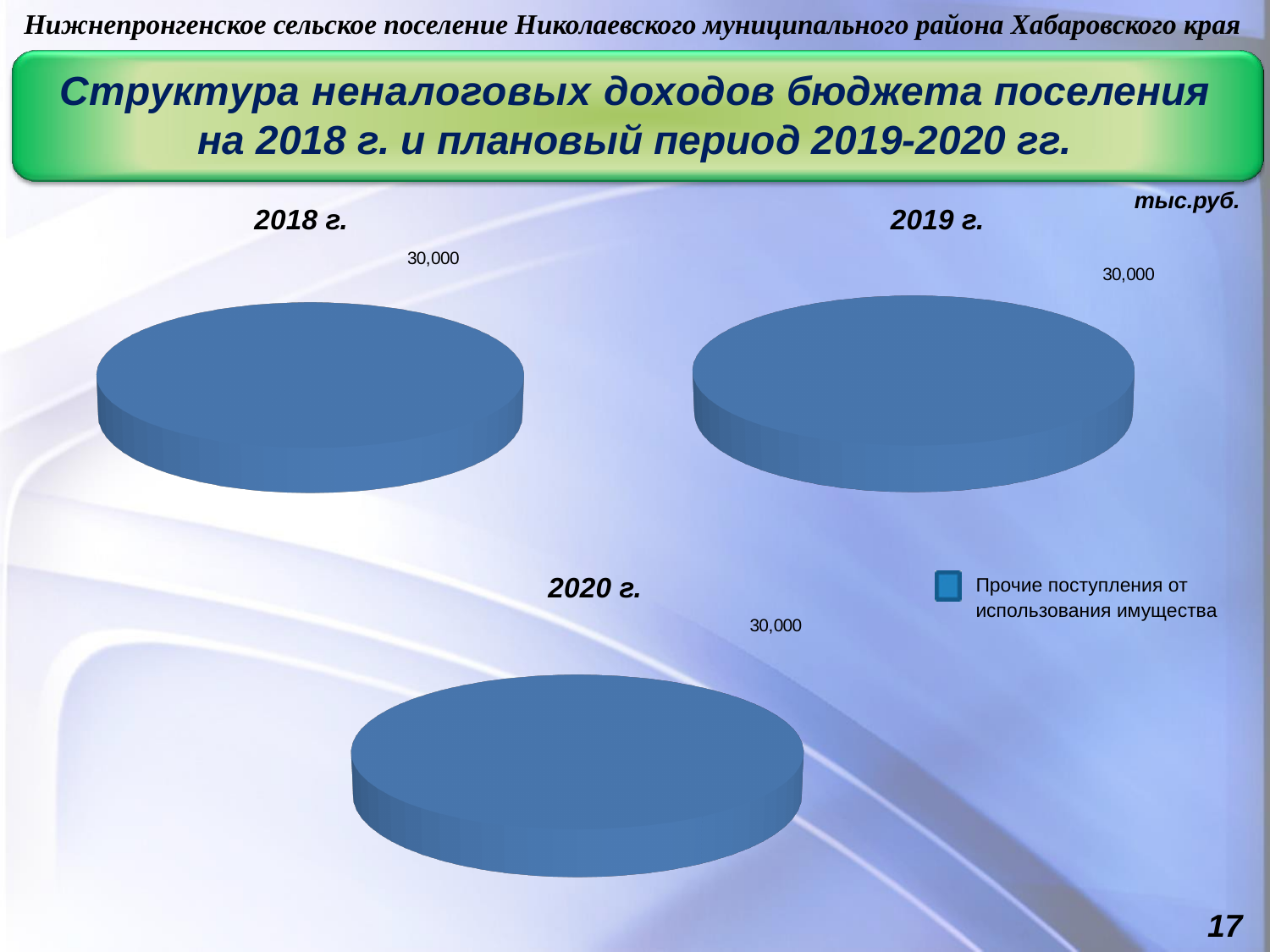
How many charts are shown on the slide? 3 How many slices does the 2020 г. pie chart have? 1 In what units are the chart values given, according to the slide? тыс.руб. How many entries does the legend list? 1 In the 2019 г. chart, what is the value shown for Прочие поступления от использования имущества? 30,000 Is the value in the 2018 г. chart larger than, smaller than, or equal to the value in the 2020 г. chart? equal What is the legend entry shown on the slide? Прочие поступления от использования имущества What share of the 2019 г. pie does Прочие поступления от использования имущества represent? 100% In the 2020 г. chart, what is the value shown for Прочие поступления от использования имущества? 30,000 What kind of chart is the 2018 г. chart? pie chart In the 2018 г. chart, what is the value shown for Прочие поступления от использования имущества? 30,000 What is the difference between the 2019 г. value and the 2018 г. value? 0